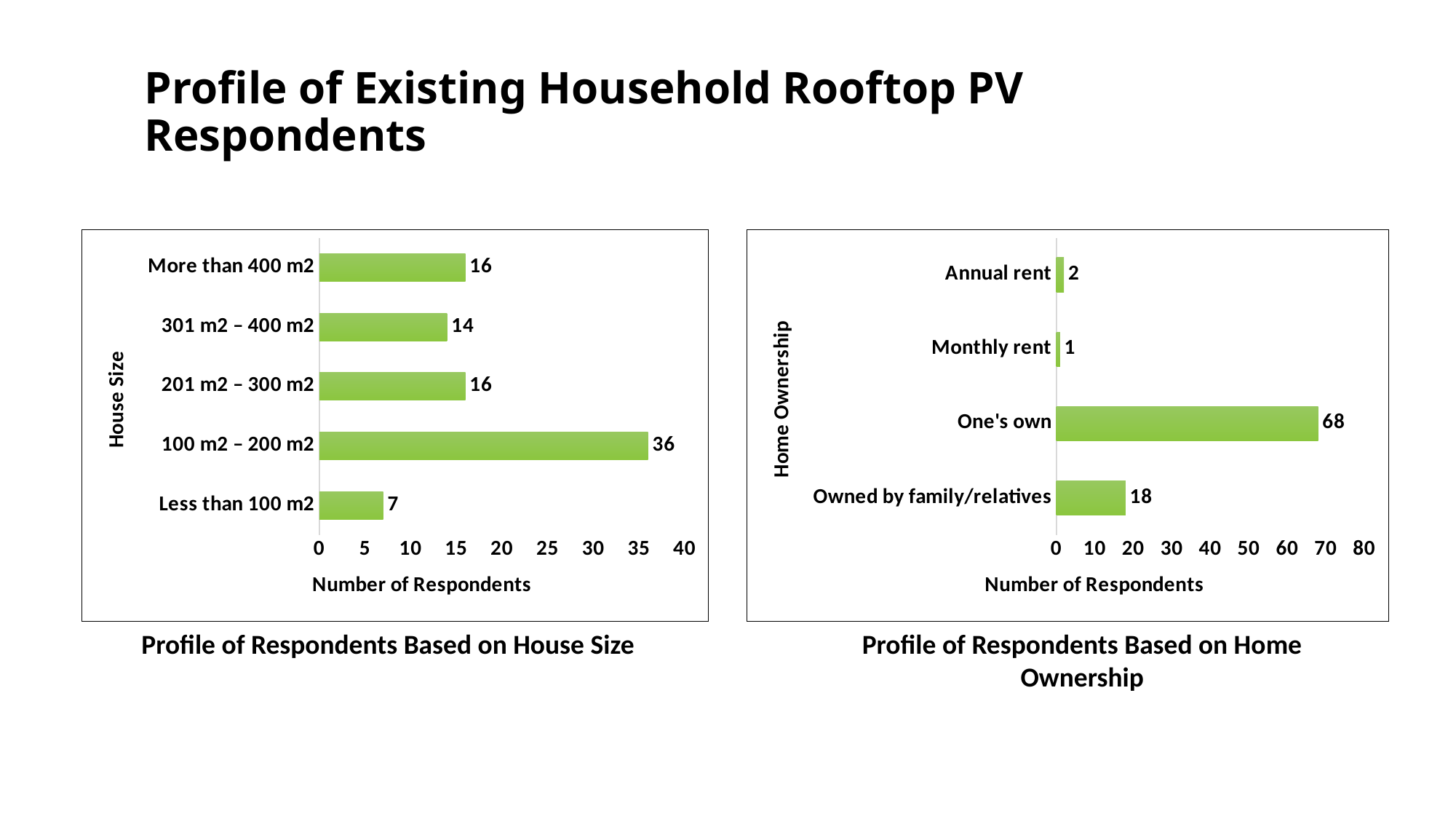
In the 'Profile of Respondents Based on Home Ownership' chart, what is the difference between the number of respondents for One's own and for Owned by family/relatives? 50 What type of chart is the 'Profile of Respondents Based on Home Ownership' chart? Bar chart In the 'Profile of Respondents Based on House Size' chart, which has more respondents: 301 m2 – 400 m2 or Less than 100 m2? 301 m2 – 400 m2 In the 'Profile of Respondents Based on House Size' chart, which house size category has the fewest respondents? Less than 100 m2 In the 'Profile of Respondents Based on House Size' chart, how many respondents have a house size of 100 m2 – 200 m2? 36 In the 'Profile of Respondents Based on Home Ownership' chart, which home ownership category has the lowest number of respondents? Monthly rent In the 'Profile of Respondents Based on House Size' chart, which house size category has the most respondents? 100 m2 – 200 m2 In the 'Profile of Respondents Based on House Size' chart, what is the difference between the number of respondents for 100 m2 – 200 m2 and for 301 m2 – 400 m2? 22 In the 'Profile of Respondents Based on House Size' chart, how many house size categories are shown? 5 What is the x-axis label of the 'Profile of Respondents Based on House Size' chart? Number of Respondents In the 'Profile of Respondents Based on Home Ownership' chart, how many respondents live in a home that is one's own? 68 In the 'Profile of Respondents Based on Home Ownership' chart, how many home ownership categories are shown? 4